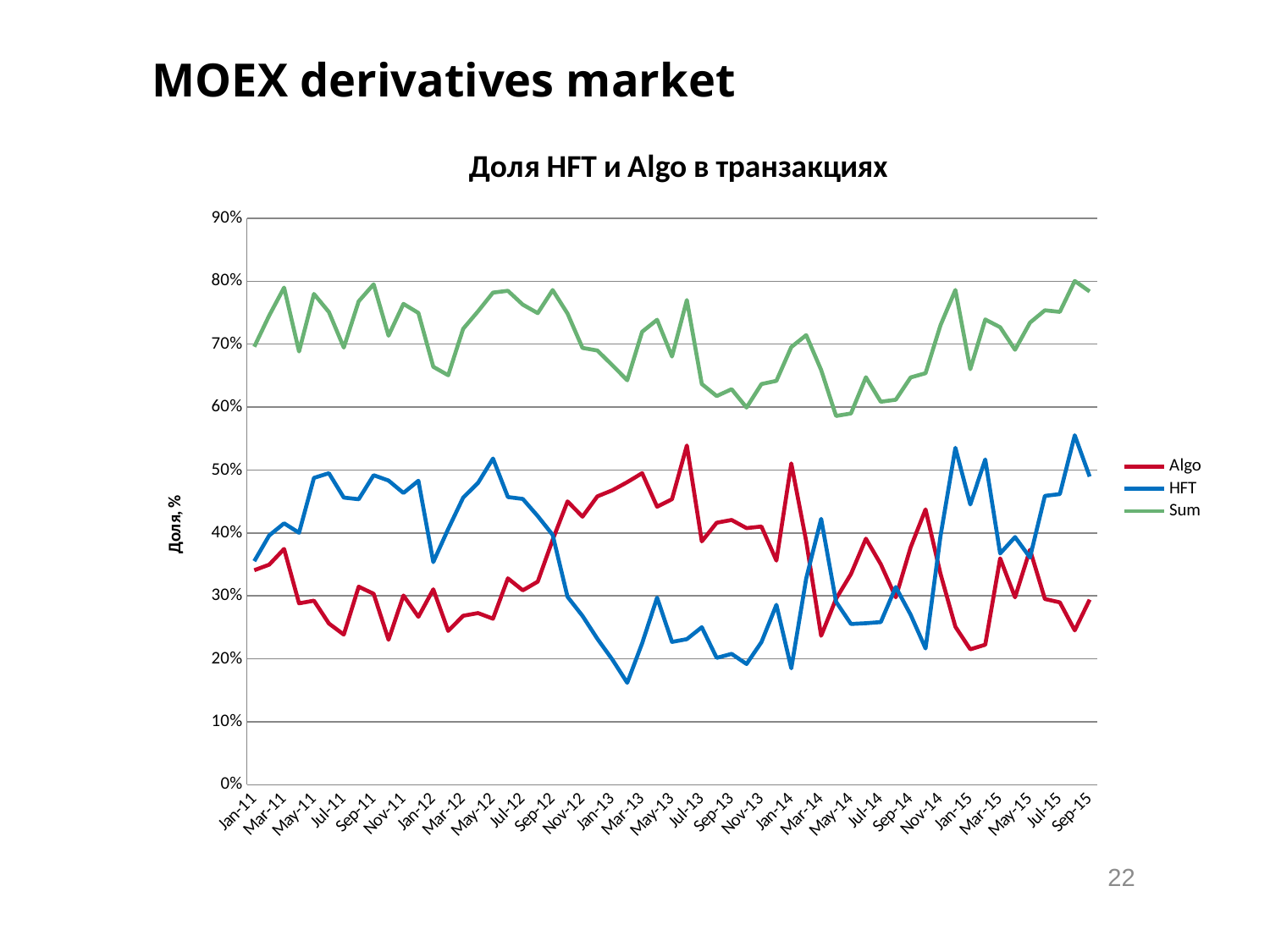
At which month does the HFT series reach its lowest value? Feb-13 What is the title of the chart? Доля HFT и Algo в транзакциях Is the value for Sum at May-14 greater or less than 60%? less What kind of chart is shown on the slide? line chart How many series does the legend list? 3 Is the value for Algo at Jul-13 greater or less than 50%? less Is the value for HFT at Jul-15 greater or less than 50%? less Which series is drawn in green? Sum At Jan-13, which is larger, Algo or HFT? Algo At Jul-11, which is larger, Algo or HFT? HFT